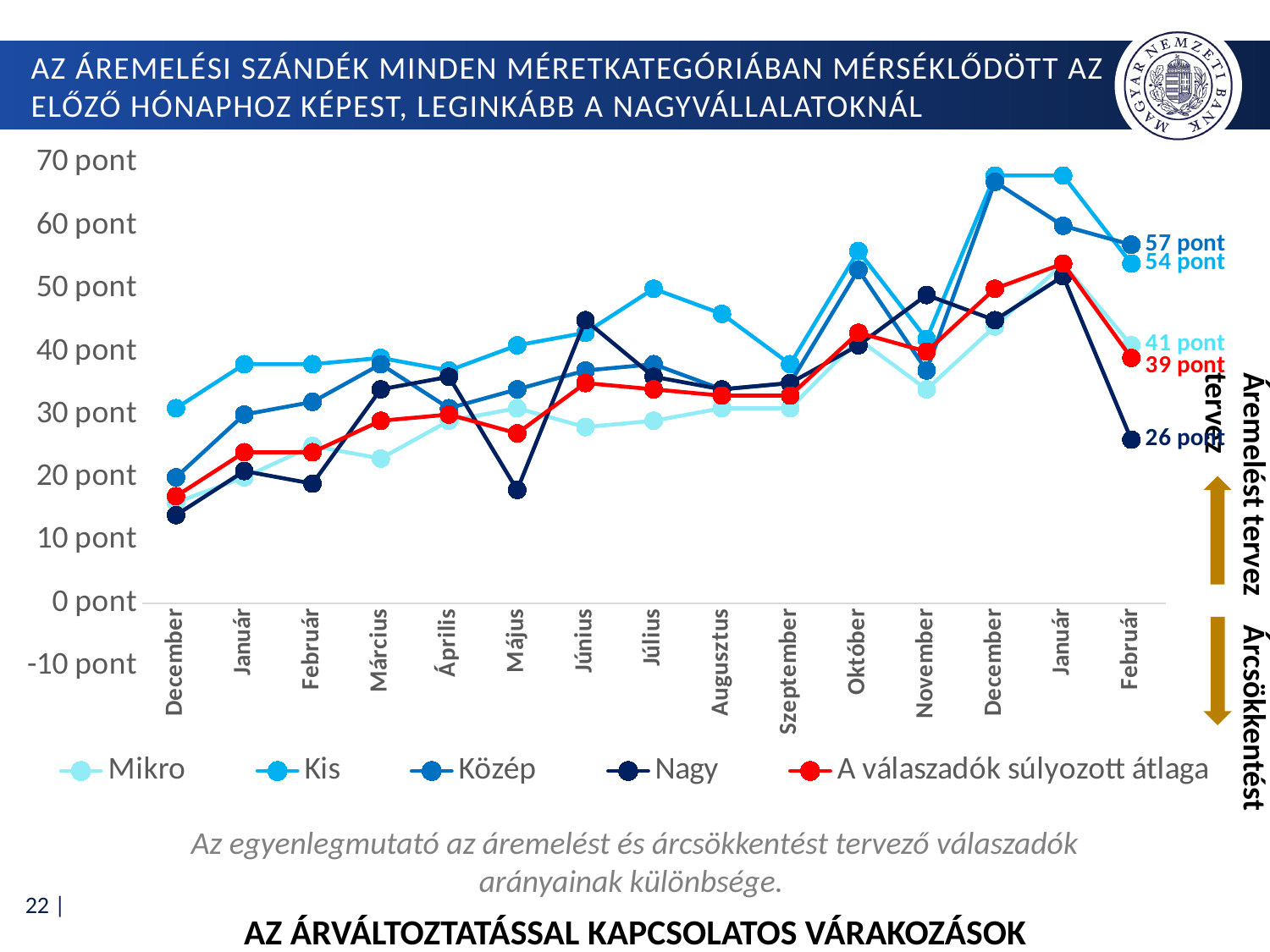
What is the value for 'A válaszadók súlyozott átlaga' at the final Február point? 39 pont What is the value for the Közép series at the final Február point? 57 pont At the final Február point, which is larger: the Kis value or the Közép value? Közép How many months are shown along the x axis? 15 Is the value for the Nagy series in November greater or less than 40 pont? greater How many series does the legend list? 5 Which series has the lowest value at the final Február point? Nagy What is the value for the Nagy series at the final Február point? 26 pont What is the difference between the Kis and Mikro values at the final Február point? 13 pont Does the Kis series rise or fall between Szeptember and the second December? rise What type of chart is shown on the slide? line chart Which series has the highest value at the final Február point? Közép